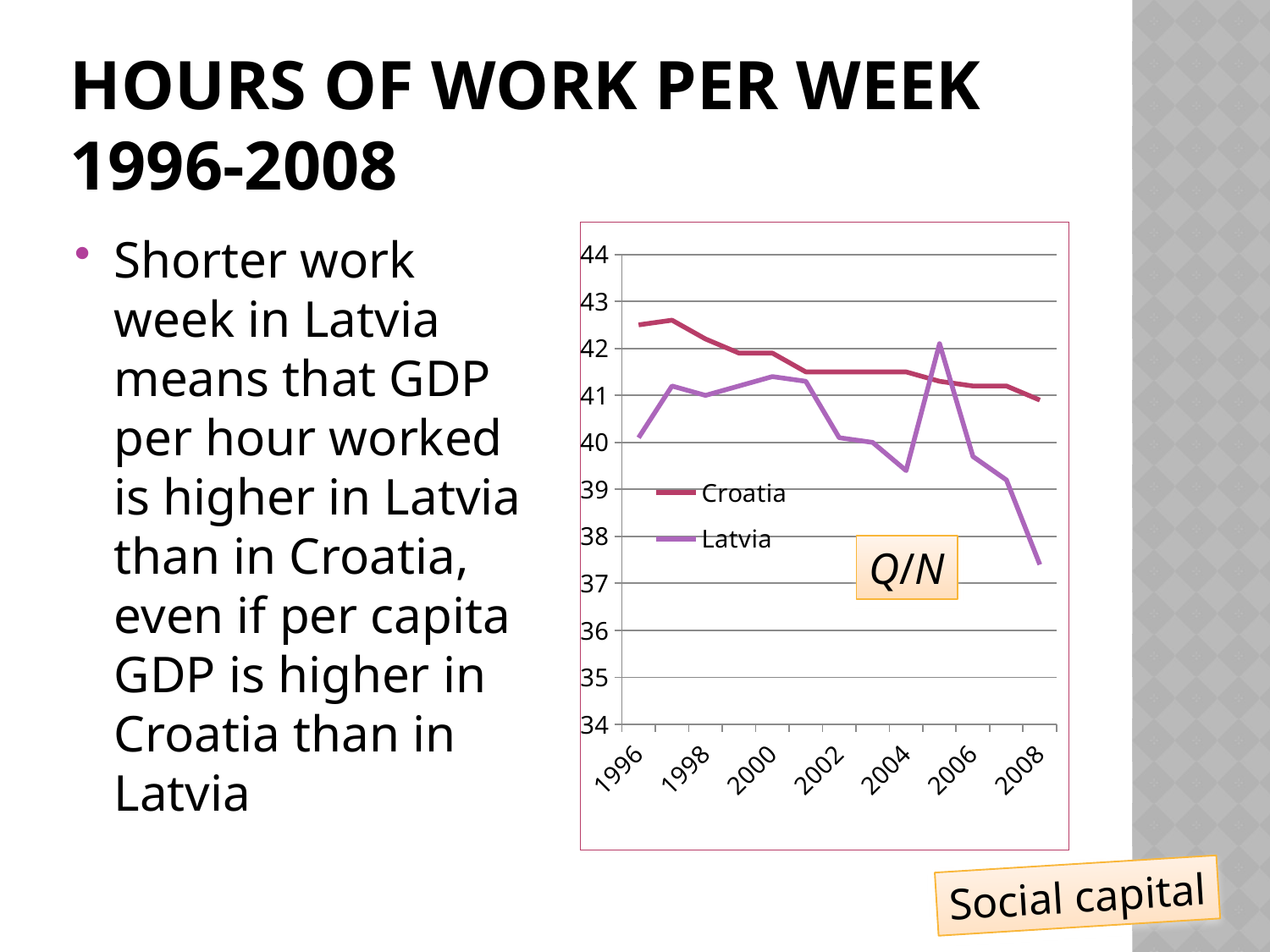
Is the value for Latvia in 2004 greater or less than 40? less In 2008, which country has the higher value, Croatia or Latvia? Croatia In which year does the Latvia line reach its highest value? 2005 Does the Croatia line generally rise or fall from 1996 to 2008? fall In 2005, which country has the higher value, Croatia or Latvia? Latvia How many series does the chart's legend list? 2 Is the value for Croatia in 1996 greater or less than 42? greater Is the value for Latvia in 2008 greater or less than 38? less In which year does the Latvia line reach its lowest value? 2008 What kind of chart is shown on the slide? line chart Which two countries are plotted in the chart? Croatia and Latvia How many years are plotted along the x axis of the chart? 13